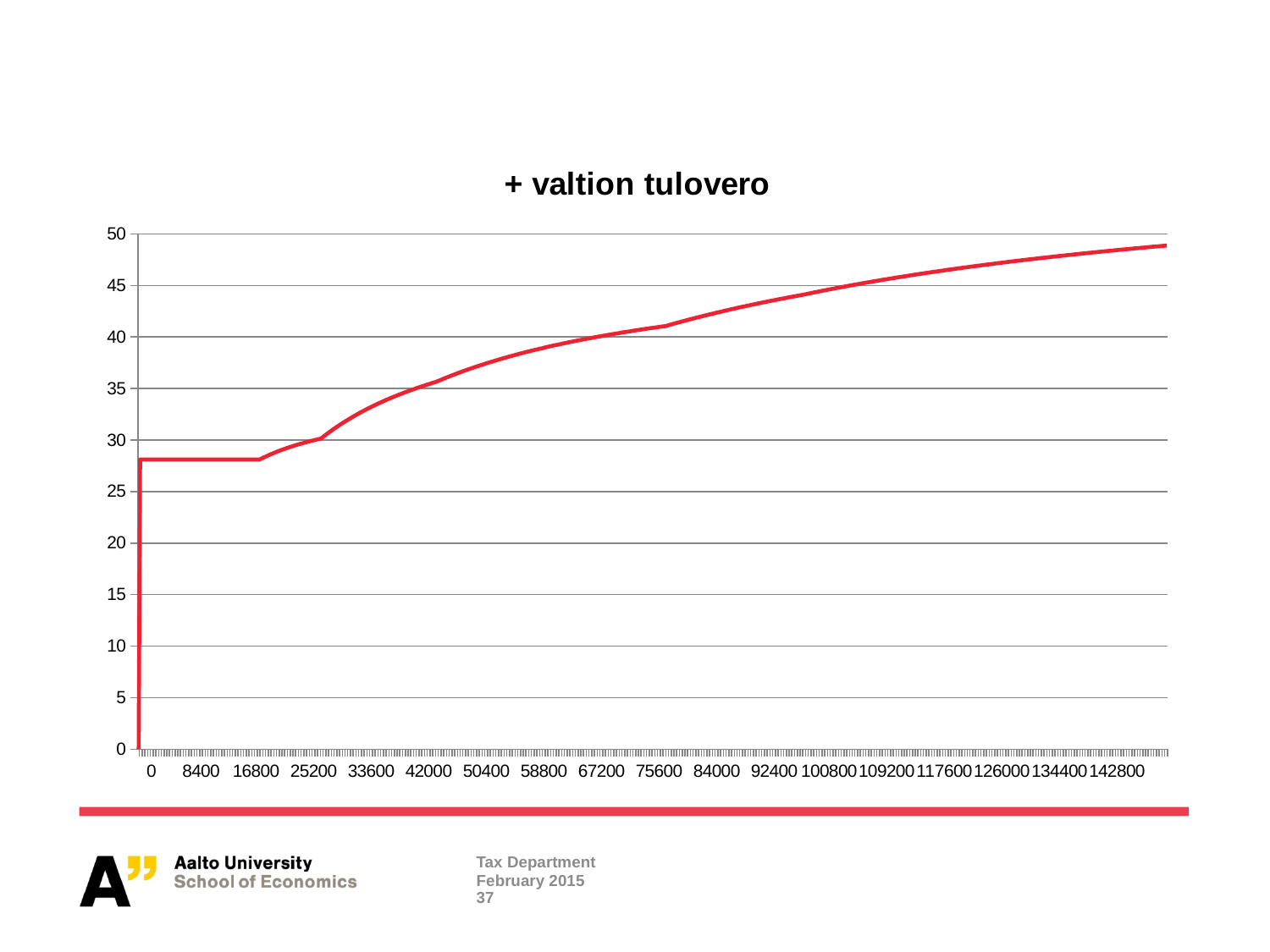
Is the value at 33600 greater or less than 30? greater Is the value at 8400 greater or less than 30? less Which is larger, the value at 8400 or the value at 142800? 142800 Is the value at 84000 greater or less than 40? greater What kind of chart is shown on the slide? line chart Does the plotted line rise or fall as the x-axis values increase from 16800 to 142800? rise What is the title of the chart? + valtion tulovero What colour is the plotted line? red